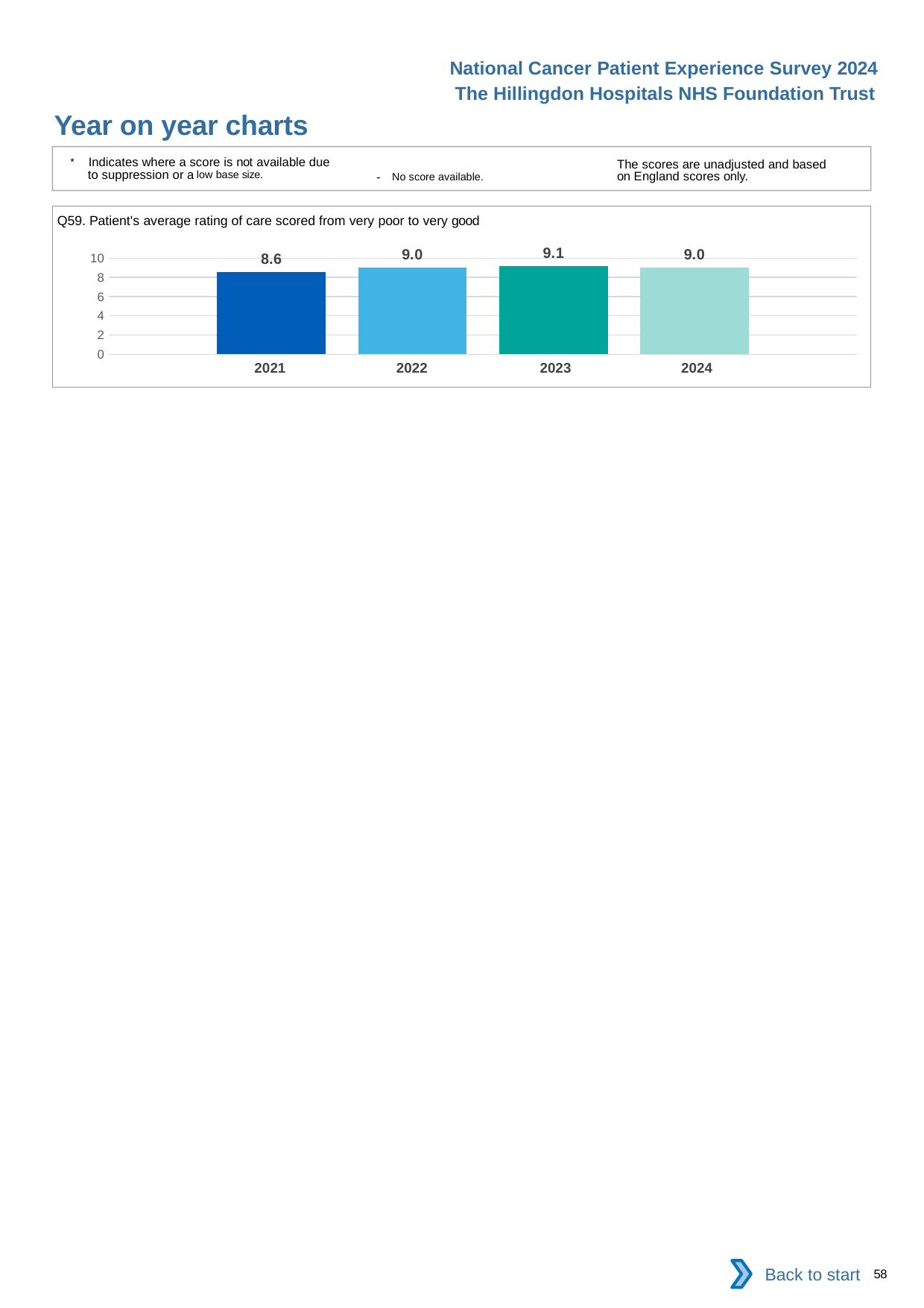
Do the values rise or fall from 2021 to 2023? rise What is the difference between the values for 2023 and 2021? 0.5 Which year has the lowest value? 2021 Is the value for 2021 greater or less than 8? greater How many years are shown on the chart? 4 What is the title of the chart? Q59. Patient's average rating of care scored from very poor to very good What is the value for 2021? 8.6 What is the value for 2023? 9.1 What is the value for 2024? 9.0 What kind of chart is shown? bar chart Which is larger, the value for 2021 or the value for 2022? 2022 Which year has the highest value? 2023